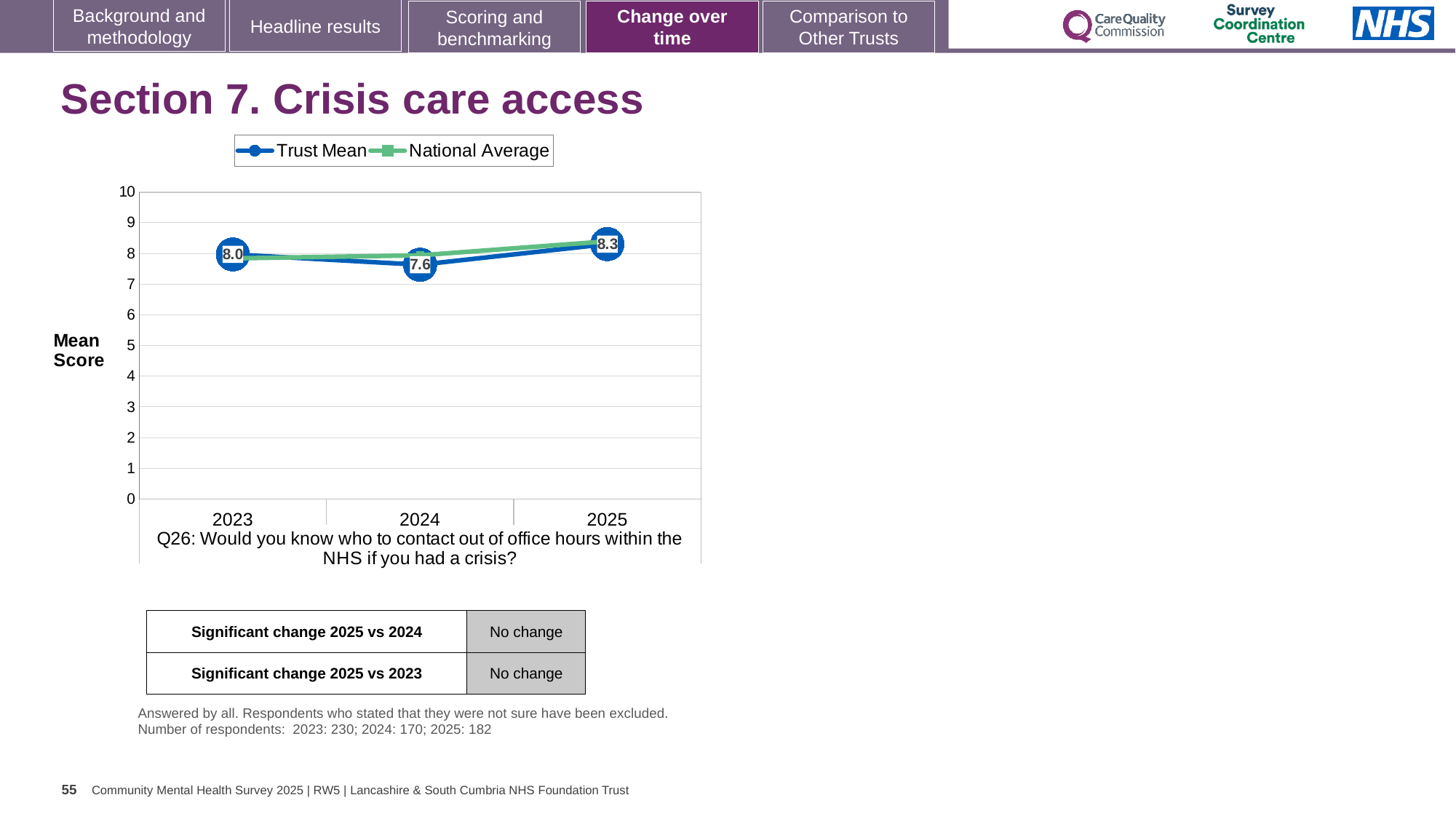
In which year is the Trust Mean score highest? 2025 What is the Trust Mean score for 2025 on the Q26 chart? 8.3 What is the Trust Mean score for 2023 on the Q26 chart? 8.0 Which is larger, the Trust Mean score for 2023 or for 2025? 2025 What is the difference between the Trust Mean scores for 2025 and 2024? 0.7 What is the label of the y axis on the chart? Mean Score Is the National Average value for 2024 greater or less than 7? greater In which year is the Trust Mean score lowest? 2024 How many years are plotted on the x axis of the chart? 3 What is the Trust Mean score for 2024 on the Q26 chart? 7.6 How many series does the chart legend list? 2 What kind of chart is shown on the slide? Line chart